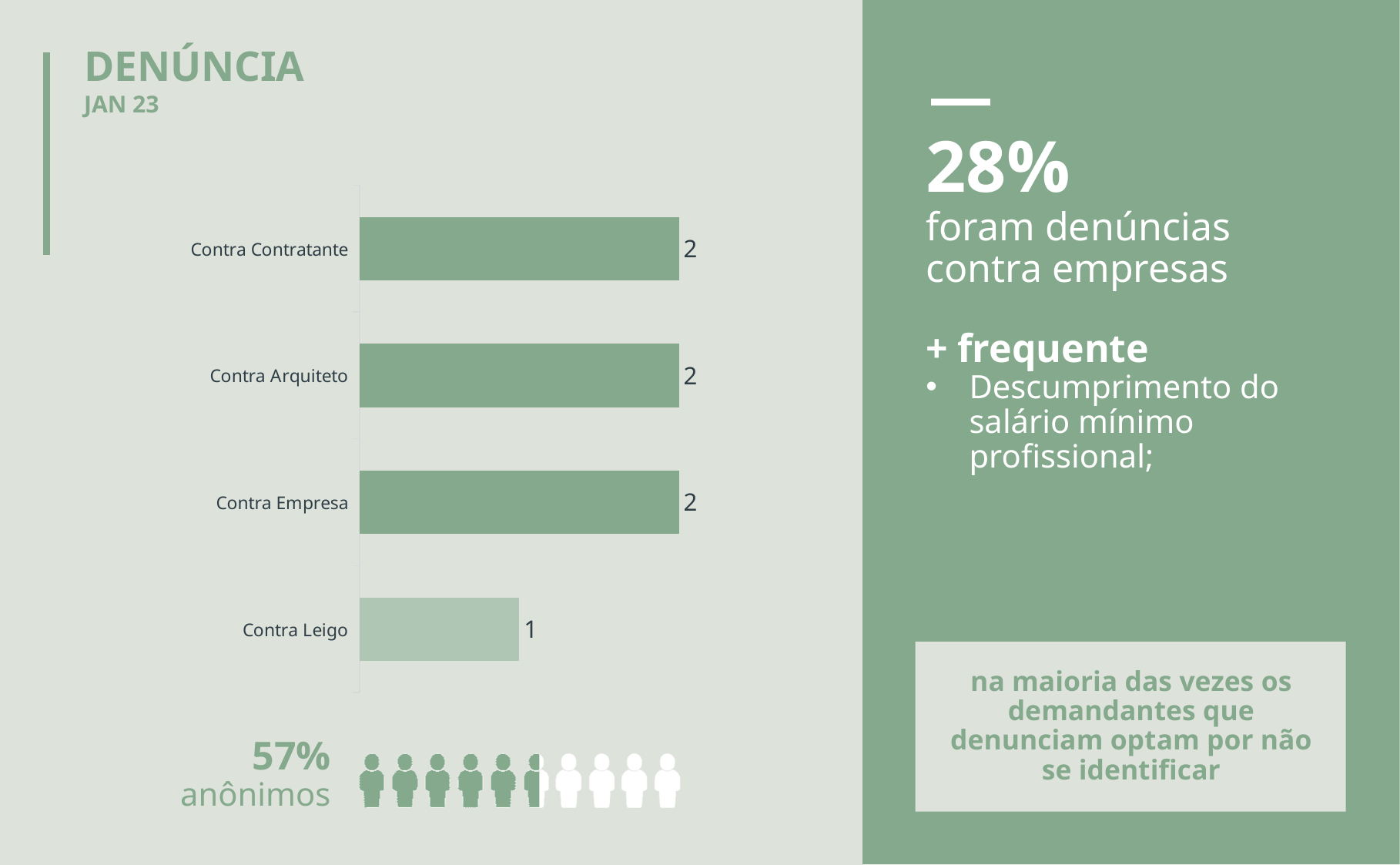
Which is larger, the value for Contra Arquiteto or the value for Contra Leigo? Contra Arquiteto Which bar is drawn in a lighter shade of green than the others? Contra Leigo Which category has the lowest value? Contra Leigo What is the value for Contra Contratante? 2 What is the value for Contra Arquiteto? 2 What is the difference between the values for Contra Empresa and Contra Leigo? 1 What is the value for Contra Empresa? 2 What kind of chart is shown on the slide? bar chart What is the value for Contra Leigo? 1 What is the title shown above the chart? DENÚNCIA What is the total of all the values shown in the chart? 7 How many categories does the chart show? 4